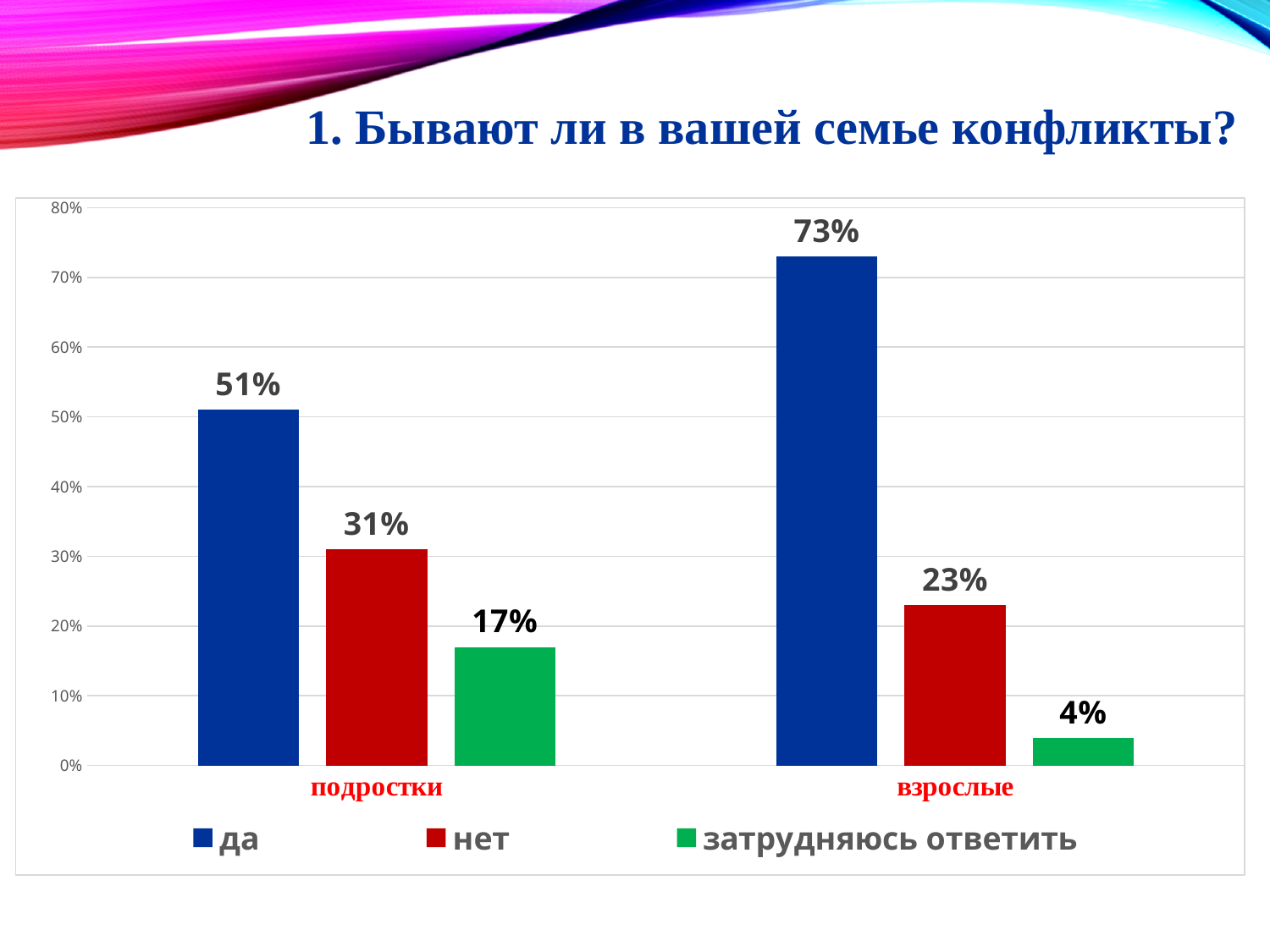
What percentage of взрослые answered нет? 23% What is the value for затрудняюсь ответить among взрослые? 4% How many categories are shown on the x axis? 2 What is the value for затрудняюсь ответить among подростки? 17% What is the difference between the да values for взрослые and подростки? 22% What is the difference between нет and затрудняюсь ответить for подростки? 14% What type of chart is shown on the slide? bar chart How many series does the legend list? 3 Which series has the lowest value among взрослые? затрудняюсь ответить Which group has the higher value for да? взрослые Which series has the highest value among подростки? да What percentage of подростки answered да? 51%